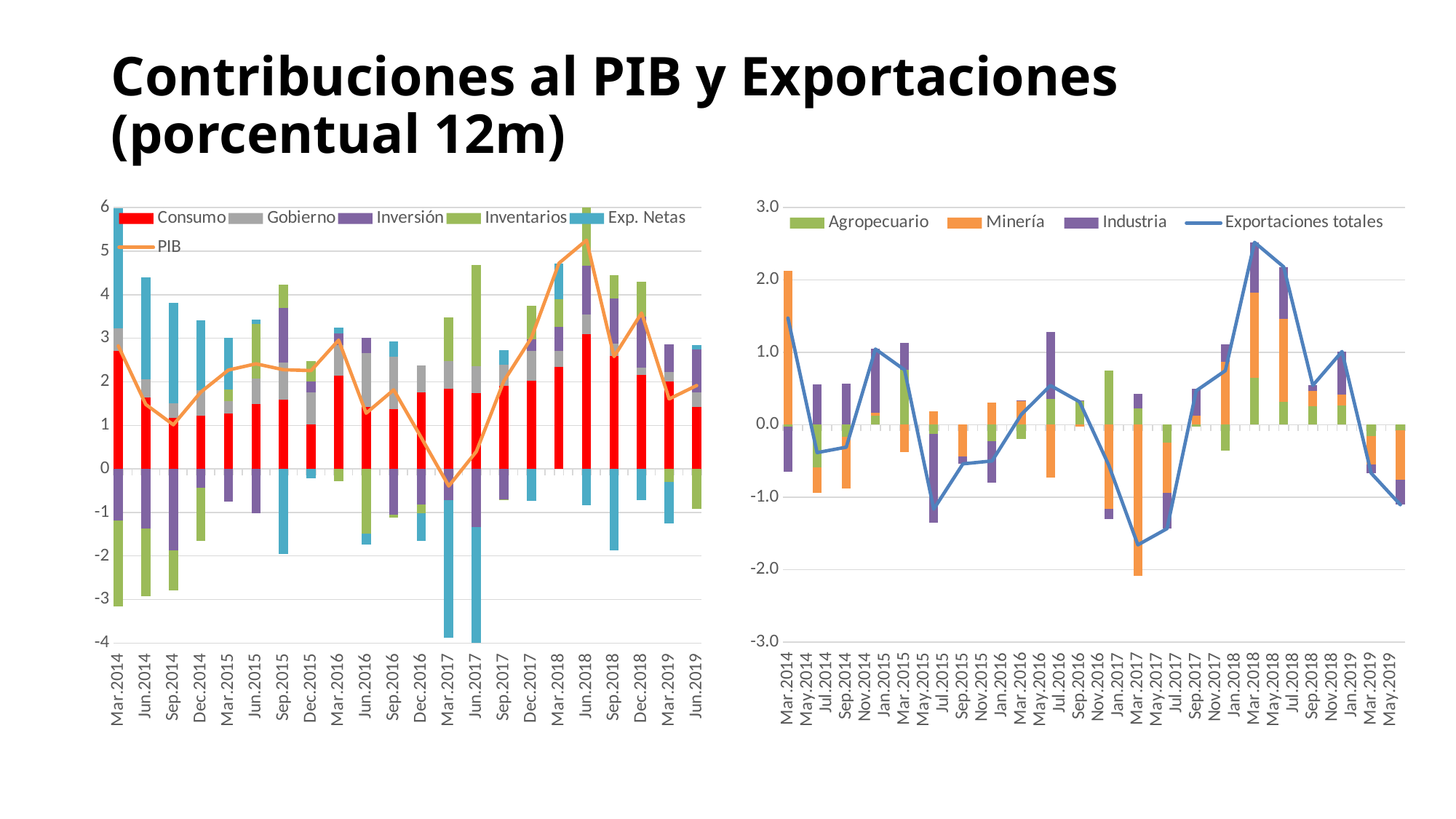
In the right chart, at which period does the Exportaciones totales line reach its highest value? Mar.2018 In the left chart, which series is plotted as a line rather than as bars? PIB In the left chart, is the PIB value at Mar.2014 larger or smaller than the PIB value at Sep.2014? larger How many series does the legend of the left chart list? 6 In the right chart, is the value of Exportaciones totales at Mar.2017 greater or less than -1.0? less What kind of chart is the left chart? Stacked bar chart with a line In the left chart, at which period does the PIB line reach its lowest value? Mar.2017 How many time periods are shown on the x axis of the left chart? 22 In the right chart, at which period does the Exportaciones totales line reach its lowest value? Mar.2017 How many series does the legend of the right chart list? 4 In the right chart, which series is plotted as a line rather than as bars? Exportaciones totales In the left chart, at which period does the PIB line reach its highest value? Jun.2018